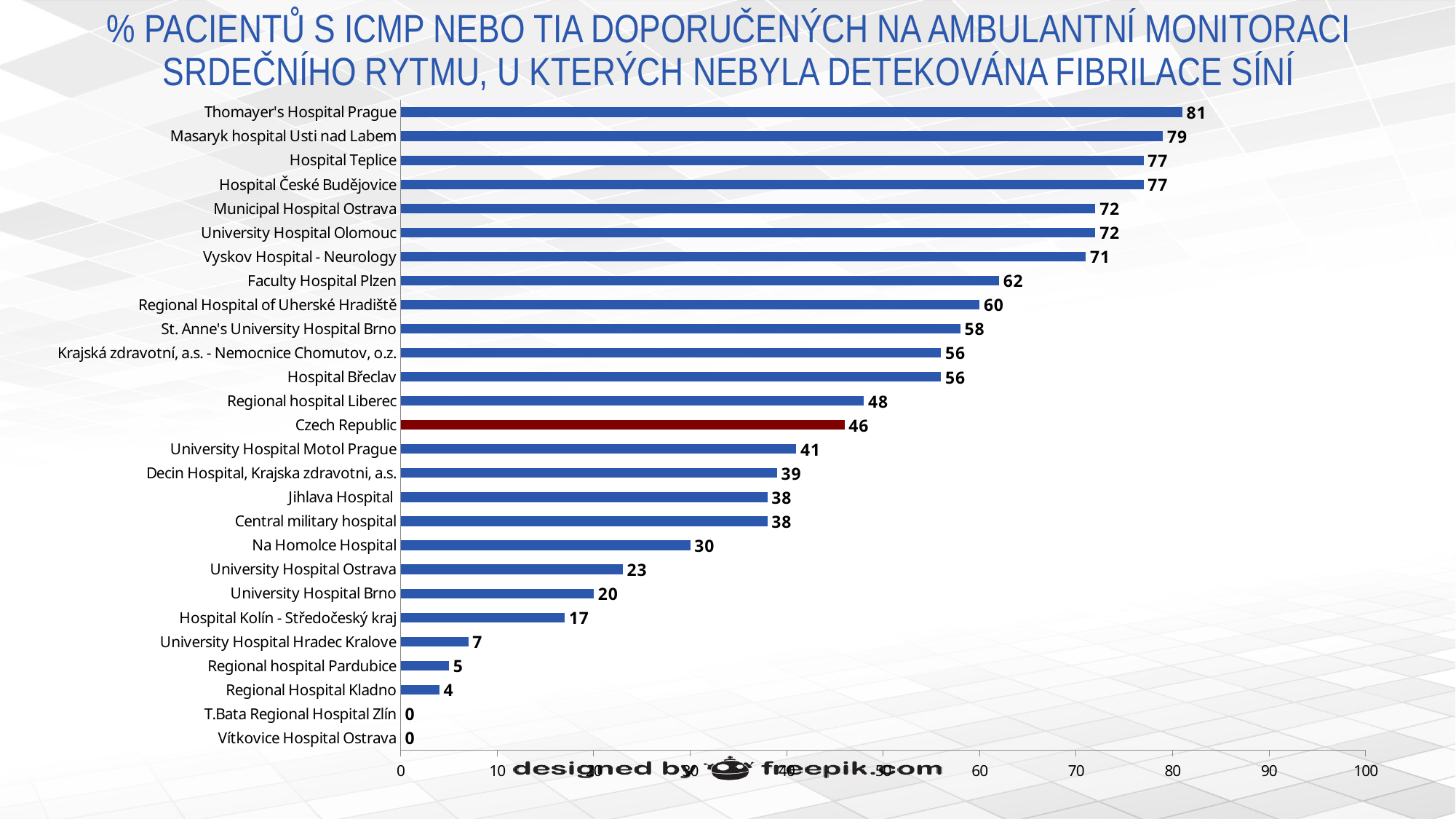
Which category has the highest value? Thomayer's Hospital Prague What is the value for Regional Hospital Kladno? 4 What is the value for Czech Republic? 46 Which is larger, the value for Faculty Hospital Plzen or the value for Na Homolce Hospital? Faculty Hospital Plzen What is the difference between the values for Masaryk hospital Usti nad Labem and Regional hospital Liberec? 31 Is the value for Vyskov Hospital - Neurology greater or less than 60? greater What is the value for Thomayer's Hospital Prague? 81 How many categories are shown on the chart? 27 What kind of chart is shown on the slide? bar chart What is the difference between the values for Czech Republic and University Hospital Brno? 26 What is the value for University Hospital Motol Prague? 41 Which category's bar is shown in a different colour (dark red) from the others? Czech Republic